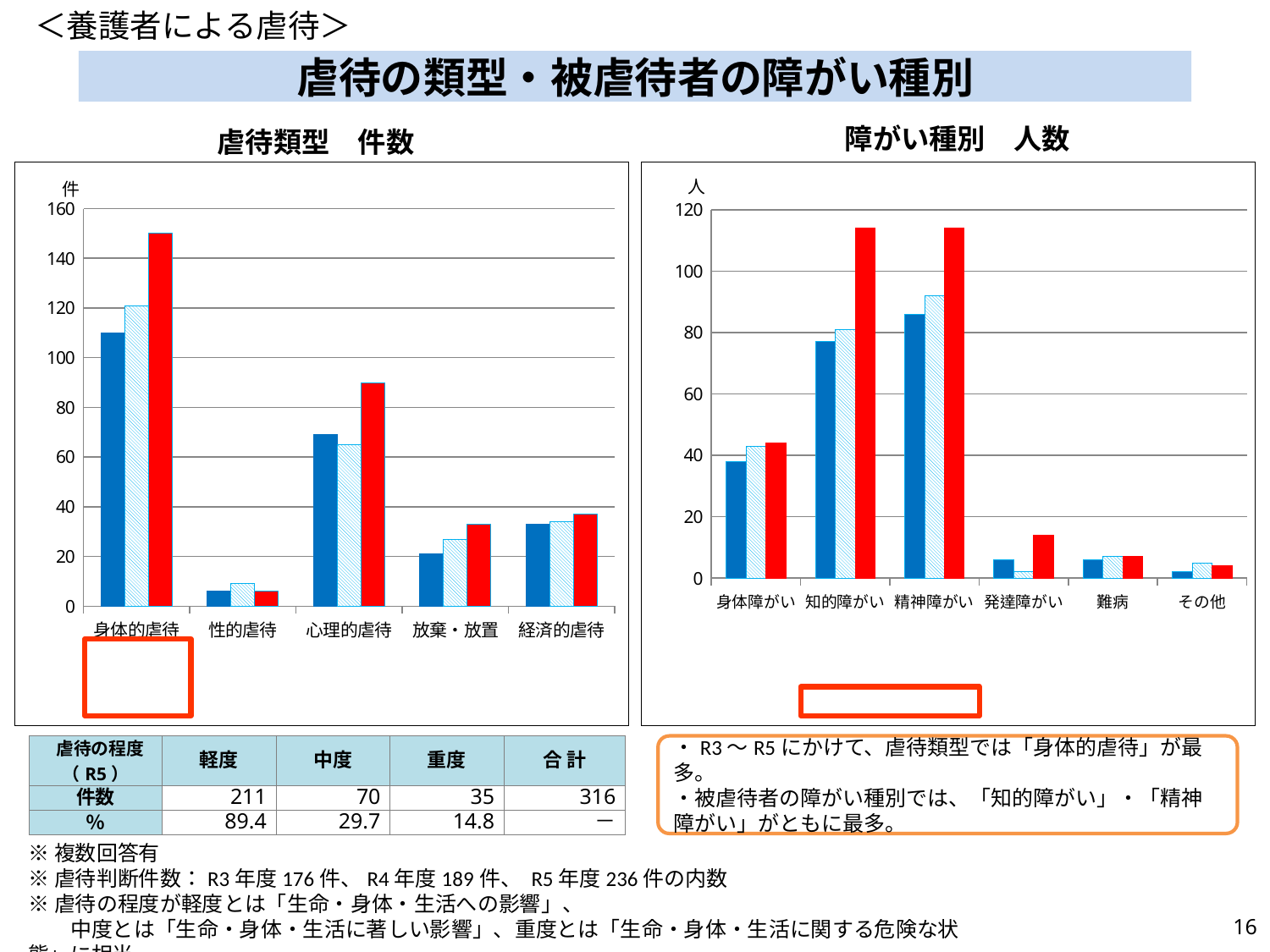
In the left chart (虐待類型 件数), is the value of the red bar for 身体的虐待 greater or less than 140? greater In the right chart (障がい種別 人数), which category has the lowest bars overall? その他 In the left chart (虐待類型 件数), which category has the lowest bars overall? 性的虐待 In the right chart (障がい種別 人数), is the value of the red bar for 知的障がい greater or less than 100? greater In the right chart (障がい種別 人数), is the value of the red bar for 発達障がい greater or less than 20? less In the right chart (障がい種別 人数), which is larger: the dark blue bar for 精神障がい or the dark blue bar for 知的障がい? 精神障がい What kind of chart is the left chart titled 虐待類型 件数? bar chart How many abuse-type categories are shown on the x axis of the left chart (虐待類型 件数)? 5 How many disability categories are shown on the x axis of the right chart (障がい種別 人数)? 6 In the left chart (虐待類型 件数), which category has the tallest bar? 身体的虐待